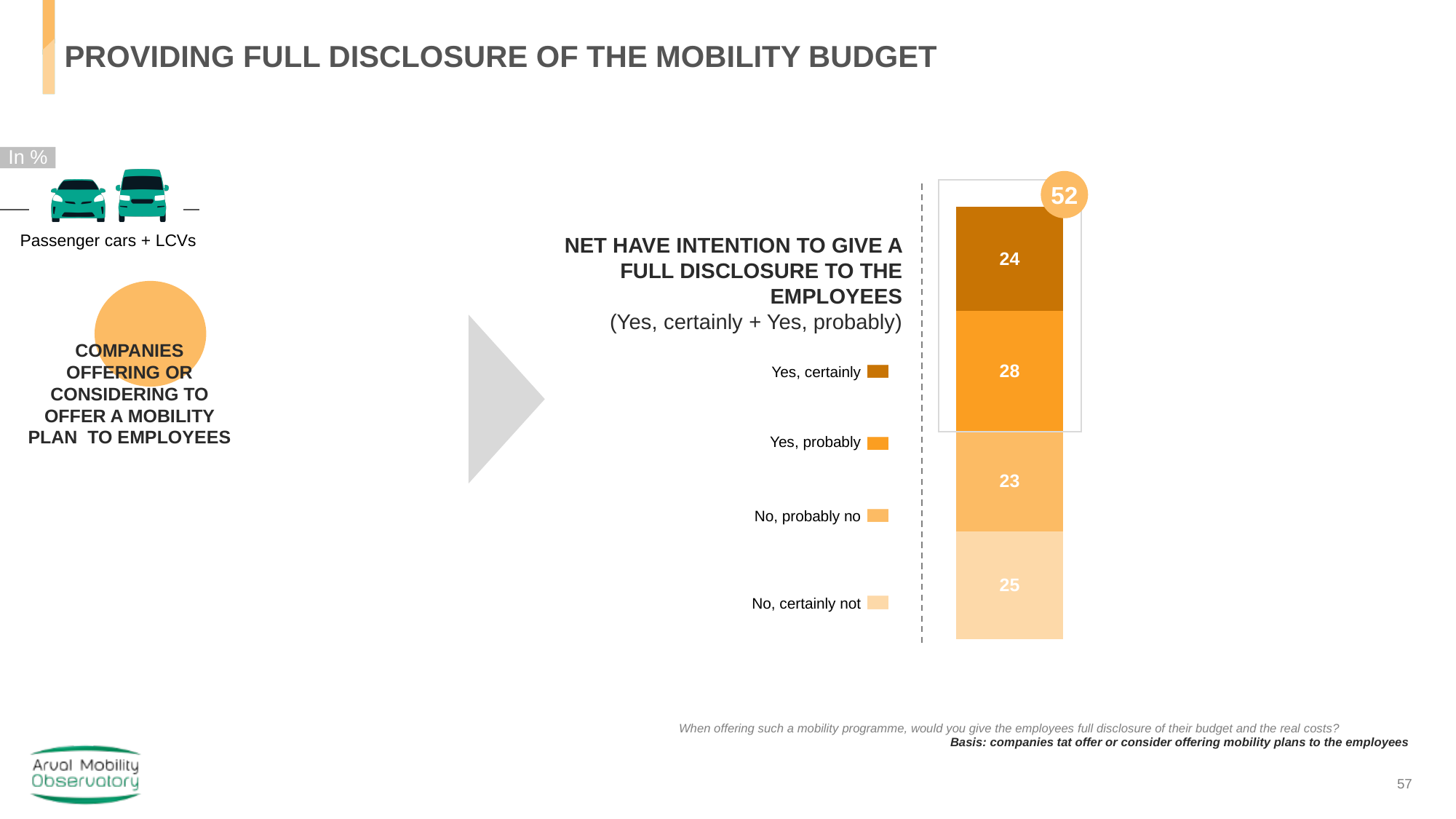
What kind of chart is used to show the responses? Stacked bar chart What percentage of companies answered "Yes, certainly" to giving full disclosure of the mobility budget? 24 What is the combined value of the two "No" responses (No, probably no + No, certainly not)? 48 Which response category has the smallest segment in the stacked bar? No, probably no Which is larger, the value for "No, certainly not" or the value for "No, probably no"? No, certainly not What is the difference between the "Yes, probably" and "Yes, certainly" values? 4 What value is shown for "Yes, probably" in the stacked bar? 28 What is the net share of companies that have the intention to give full disclosure (Yes, certainly + Yes, probably)? 52 What value is shown for "No, certainly not"? 25 How many response categories does the legend list? 4 Which response category has the largest segment in the stacked bar? Yes, probably What value is shown for "No, probably no"? 23